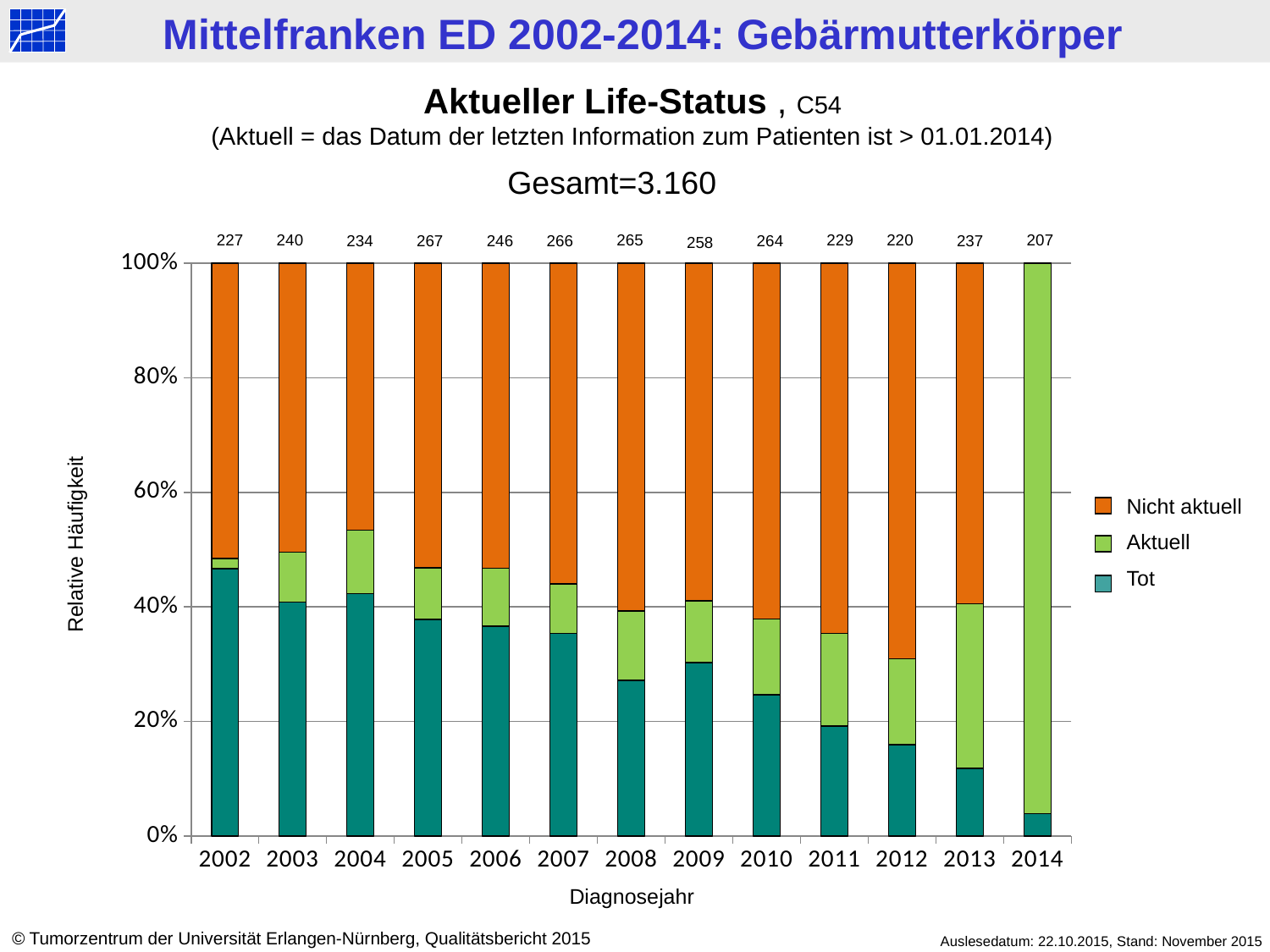
Which year has the larger number printed above its bar, 2003 or 2004? 2003 How many series does the legend list? 3 How many diagnosis years are shown on the x axis? 13 Does the 'Tot' share rise or fall from 2002 to 2014? fall Is the 'Tot' share for 2014 greater or less than 20%? less What is the difference between the numbers printed above the bars for 2005 and 2014? 60 Which diagnosis year has the highest number printed above its bar? 2005 Which diagnosis year has the lowest number printed above its bar? 2014 What kind of chart is shown on the slide? Stacked bar chart What is the number printed above the bar for 2014? 207 What is the number printed above the bar for 2005? 267 Is the 'Tot' share for 2002 greater or less than 40%? greater